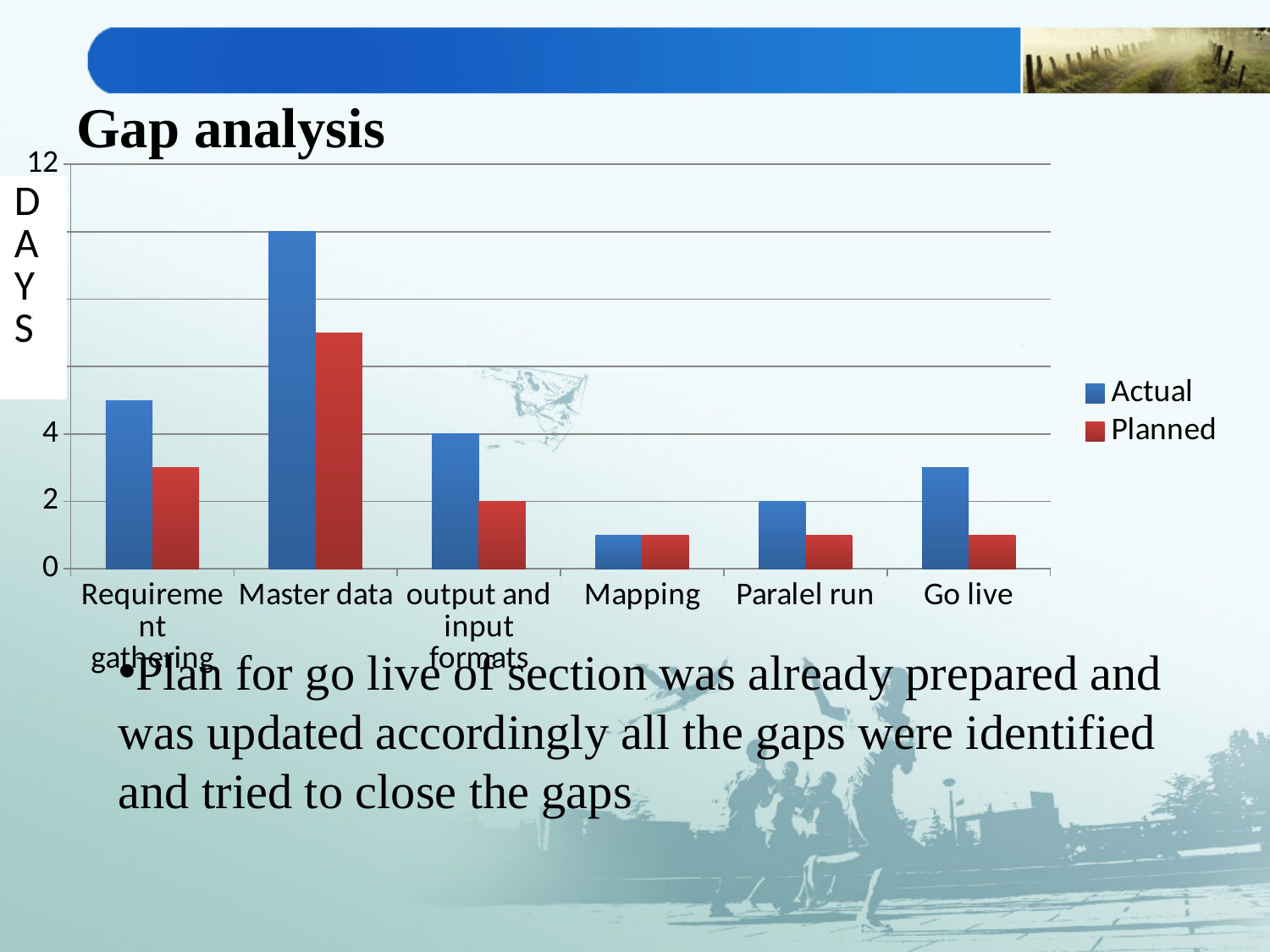
Which category has the highest Actual value? Master data Is the Actual value for Master data greater or less than 4? greater Which category has the lowest Actual value? Mapping What is the Planned value for output and input formats? 2 What is the Actual value for Paralel run? 2 How many categories are shown on the x axis? 6 Is the Planned value for Go live greater or less than 2? less For Master data, which is larger, the Actual or the Planned value? Actual What is the Actual value for output and input formats? 4 What kind of chart is shown on the slide? bar chart What is the title of the chart? Gap analysis How many series does the legend list? 2